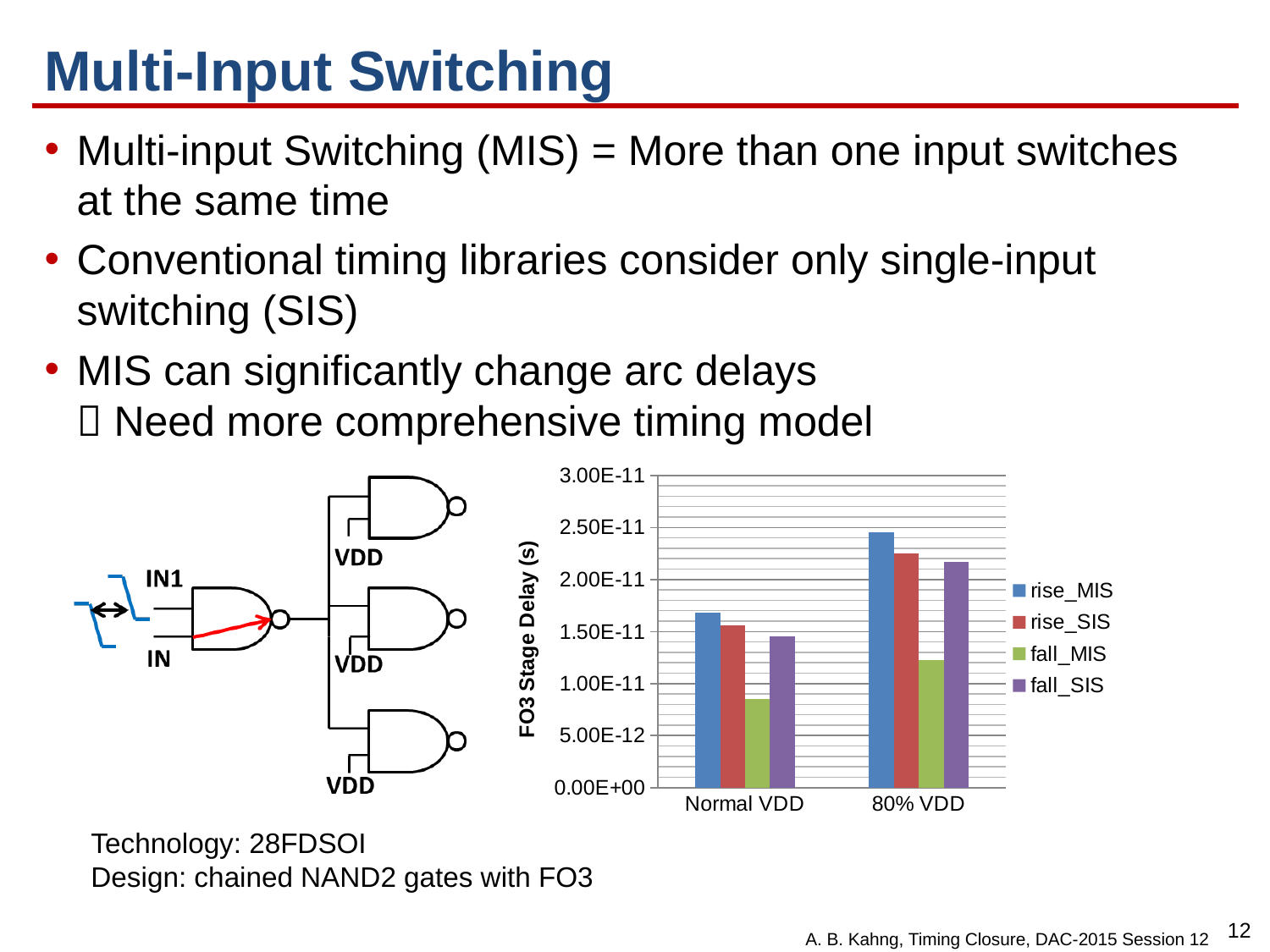
Is the value of fall_MIS for Normal VDD greater or less than 1.00E-11? less How many categories are shown on the x axis of the chart? 2 Which series has the lowest value for Normal VDD? fall_MIS Which is larger, rise_MIS for 80% VDD or rise_MIS for Normal VDD? rise_MIS for 80% VDD Which series has the lowest value for 80% VDD? fall_MIS Is the value of rise_MIS for 80% VDD greater or less than 2.00E-11? greater Which series has the highest value for 80% VDD? rise_MIS Does the fall_SIS value rise or fall from Normal VDD to 80% VDD? rise What kind of chart is shown on the slide? bar chart What is the label of the chart's y axis? FO3 Stage Delay (s) How many series does the chart's legend list? 4 Is the value of rise_MIS for Normal VDD greater or less than 1.50E-11? greater